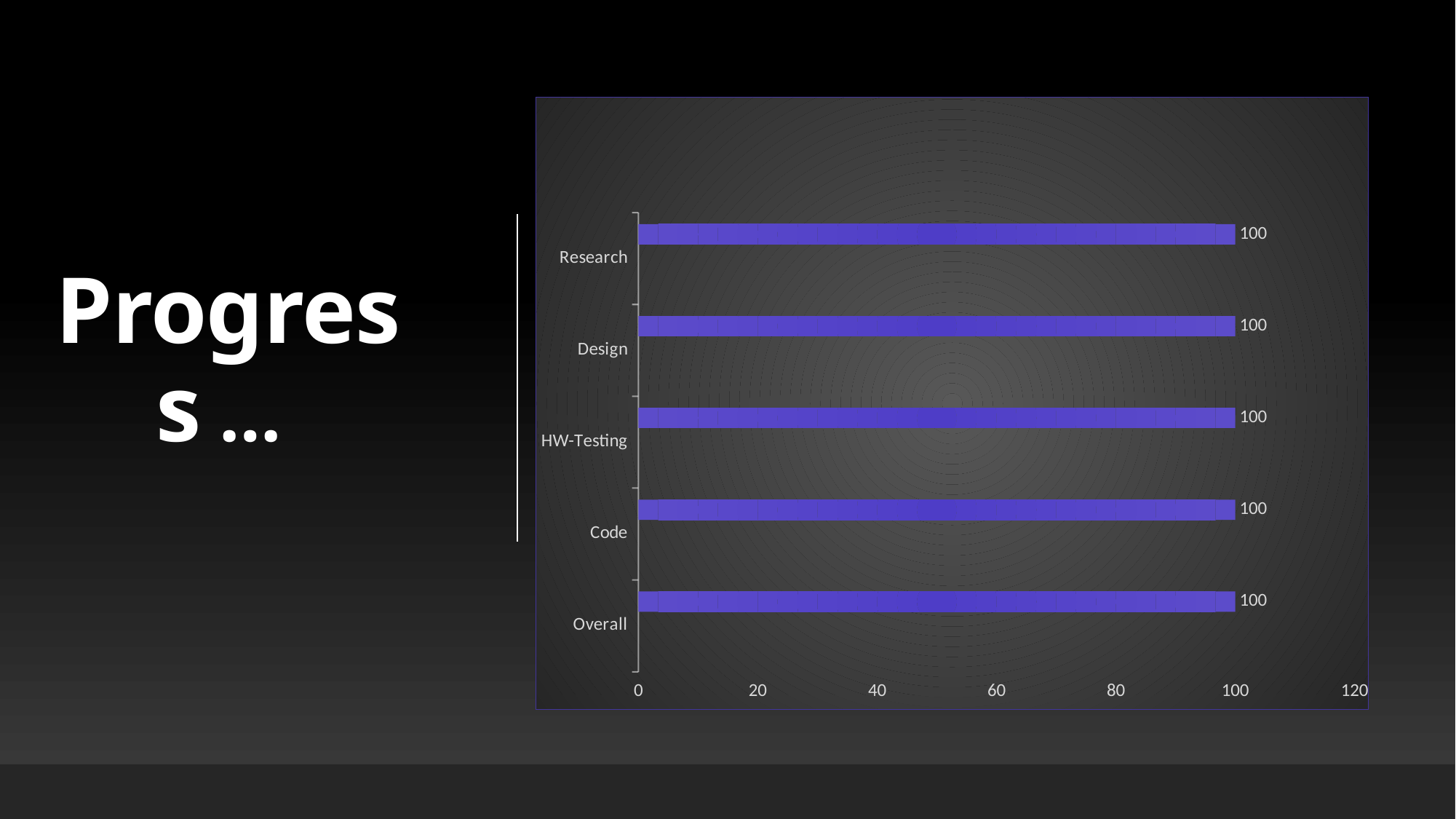
What is the value for Code? 100 What is the value for Overall? 100 What is the difference between the values for Research and Code? 0 What is the title text shown on the slide next to the chart? Progress ... How many categories are shown in the chart? 5 Is the value for Design greater or less than 80? greater What is the value for Design? 100 What is the value for Research? 100 What is the highest value shown on the horizontal axis? 120 What kind of chart is shown on the slide? bar chart Is the value for Overall greater or less than 120? less What is the value for HW-Testing? 100